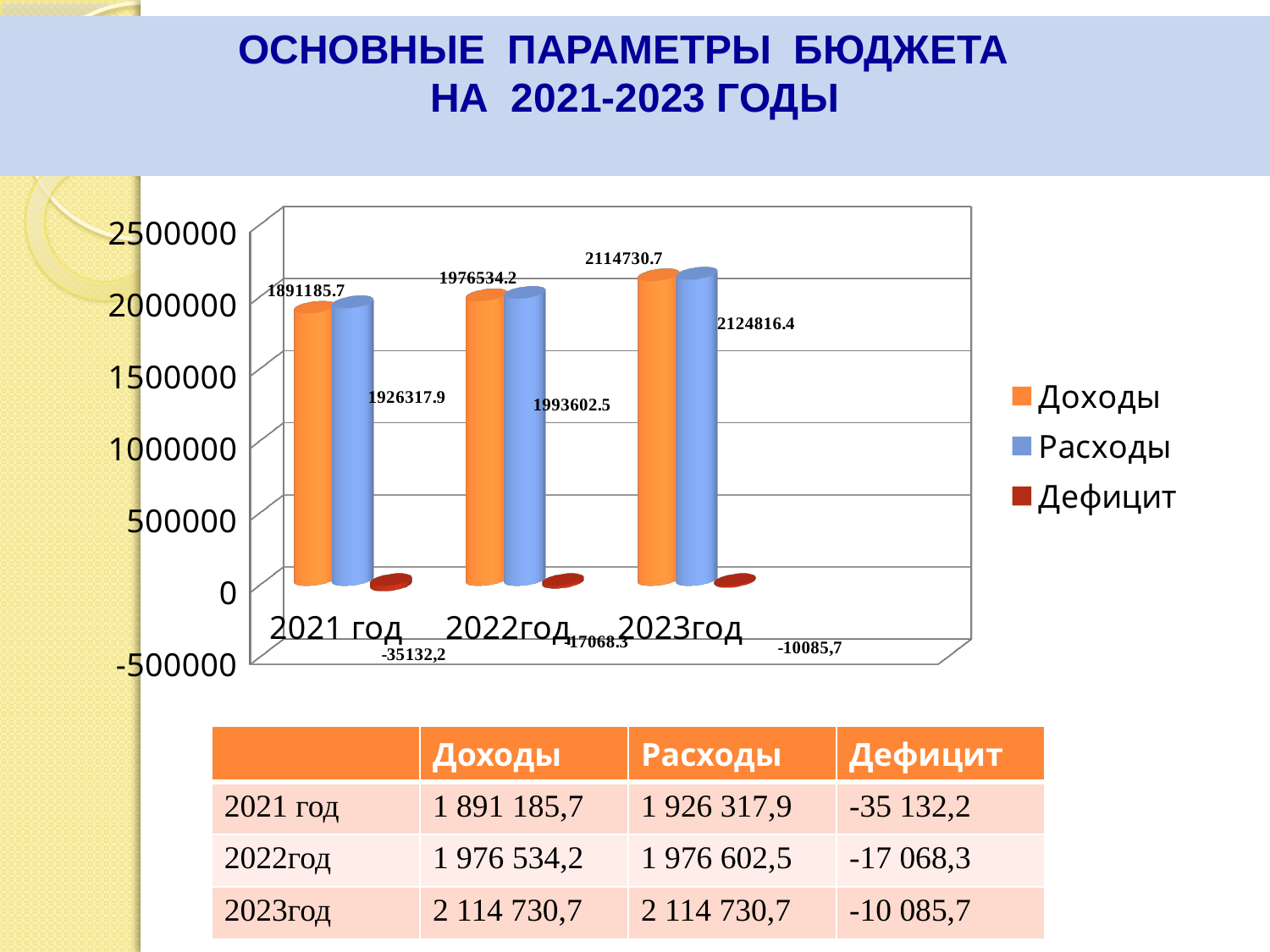
What is the value of Дефицит for 2023год in the chart? -10085,7 Which series in the legend is shown in orange? Доходы What is the value of Расходы for 2022год in the chart? 1993602.5 Is the Доходы value for 2021 год greater or less than 2000000? less Do the Доходы values rise or fall from 2021 год to 2023год? rise How many series does the chart legend list? 3 Which year has the highest Доходы value in the chart? 2023год What type of chart is shown on the slide? bar chart What is the value of Доходы for 2021 год in the chart? 1891185.7 How many year categories are plotted on the x axis of the chart? 3 Which year has the lowest Дефицит value in the chart? 2021 год What is the value of Расходы for 2023год in the chart? 2124816.4